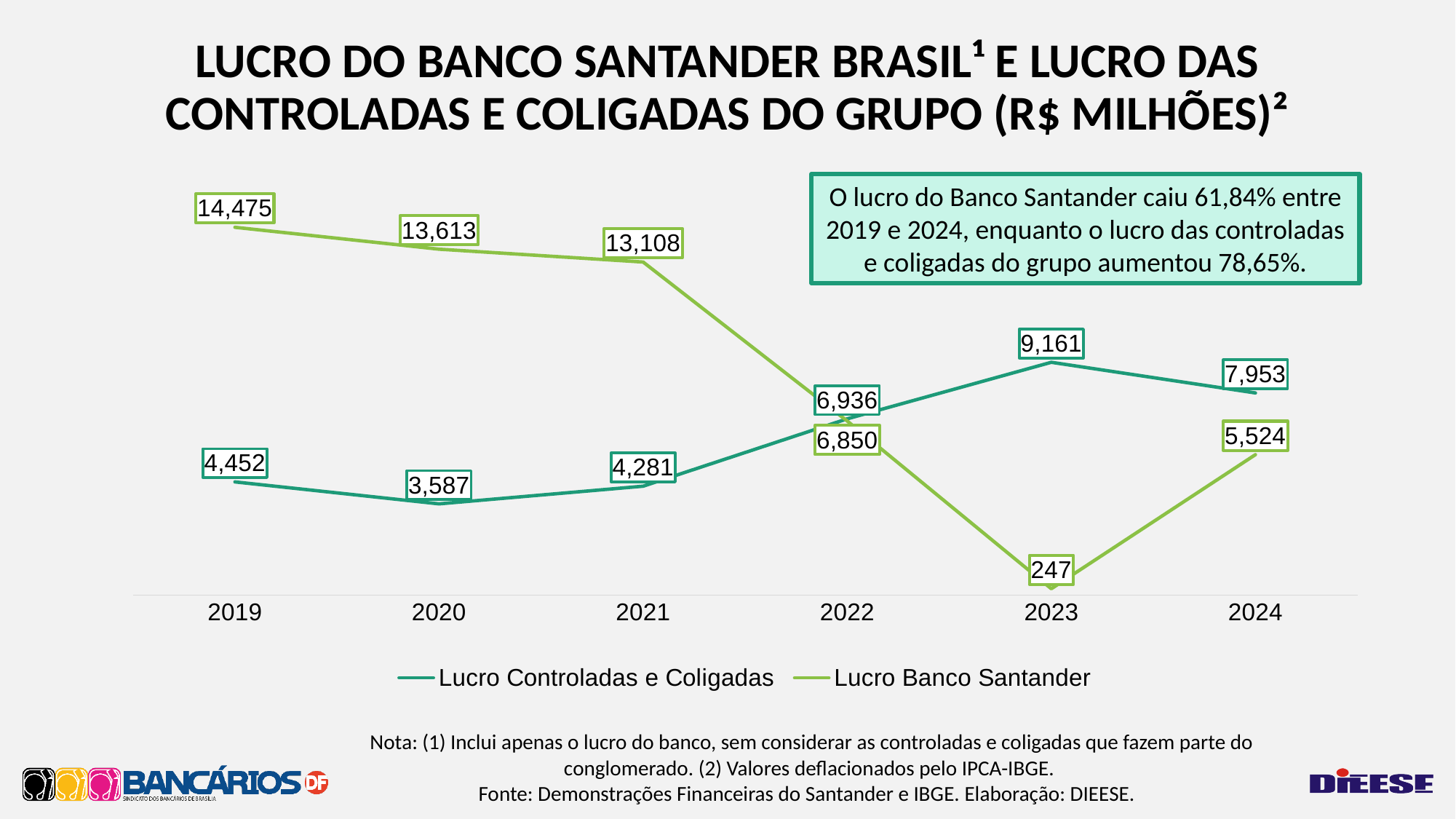
How many series does the legend list? 2 How many years are shown on the x axis? 6 What type of chart is shown on the slide? line chart What is the difference between Lucro Banco Santander in 2019 and in 2024? 8,951 Which series is drawn in the lighter green line? Lucro Banco Santander In which year is Lucro Controladas e Coligadas highest? 2023 What is the value of Lucro Banco Santander in 2023? 247 What is the value of Lucro Controladas e Coligadas in 2020? 3,587 Which is larger in 2024: Lucro Controladas e Coligadas or Lucro Banco Santander? Lucro Controladas e Coligadas What is the value of Lucro Banco Santander in 2019? 14,475 Does Lucro Banco Santander rise or fall from 2019 to 2023? fall In which year is Lucro Banco Santander lowest? 2023